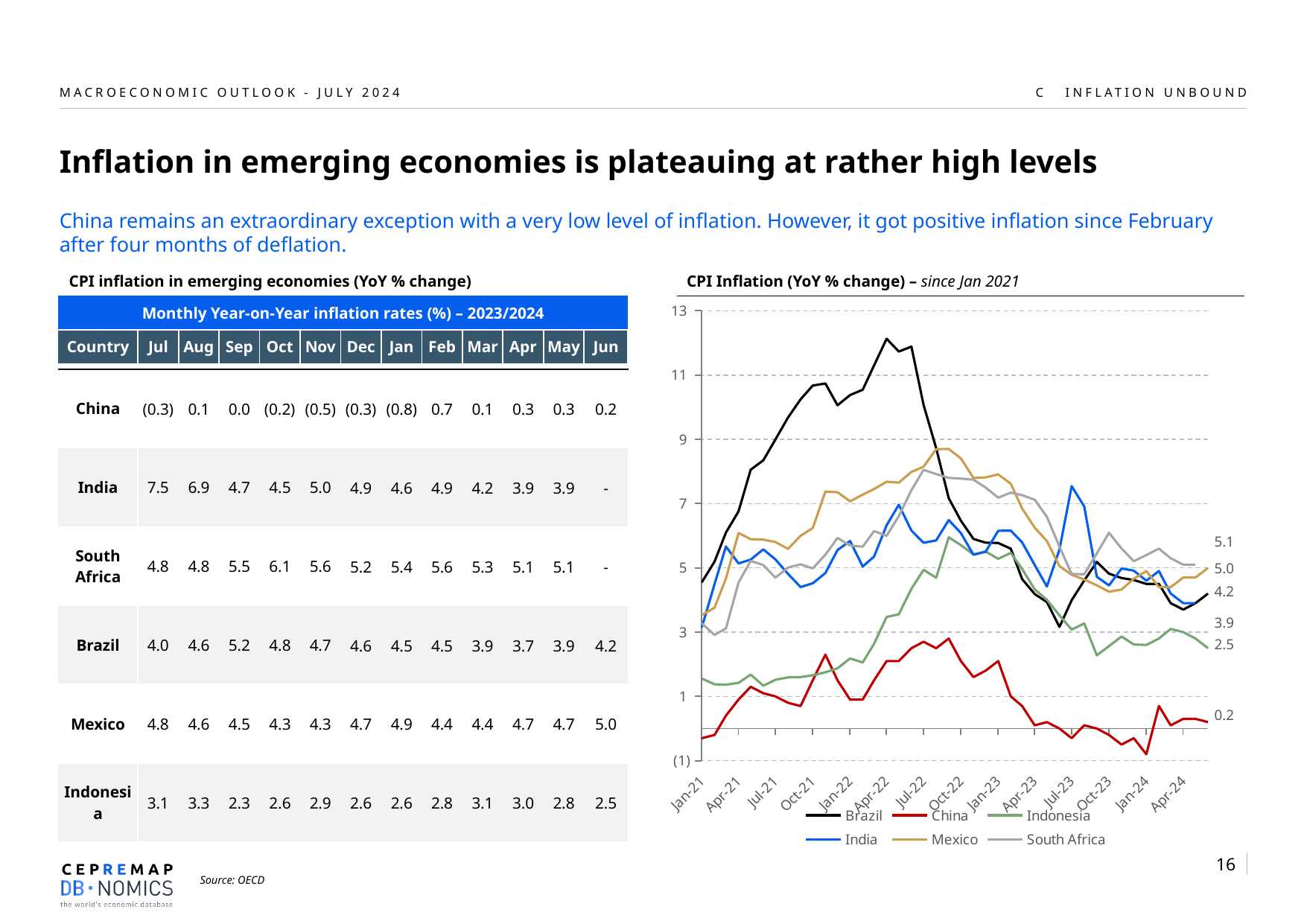
In the 'CPI Inflation (YoY % change) – since Jan 2021' chart, what is the difference between the latest labelled values for Brazil and Indonesia? 1.7 How many series does the legend of the 'CPI Inflation (YoY % change) – since Jan 2021' chart list? 6 In the 'CPI Inflation (YoY % change) – since Jan 2021' chart, does the Brazil line rise or fall between Apr-22 and Jul-23? fall In the 'CPI Inflation (YoY % change) – since Jan 2021' chart, what is the latest value labelled for China? 0.2 In the 'CPI Inflation (YoY % change) – since Jan 2021' chart, what is the latest value labelled for Mexico? 5.0 In the 'CPI Inflation (YoY % change) – since Jan 2021' chart, is the value for China in Jan-21 greater or less than 1? less In the 'CPI Inflation (YoY % change) – since Jan 2021' chart, what colour is the Brazil line? black In the 'CPI Inflation (YoY % change) – since Jan 2021' chart, which country has the highest latest labelled value? South Africa In the 'CPI Inflation (YoY % change) – since Jan 2021' chart, which country has the lowest latest labelled value? China What kind of chart is the 'CPI Inflation (YoY % change) – since Jan 2021' chart? line chart In the 'CPI Inflation (YoY % change) – since Jan 2021' chart, what is the latest value labelled for South Africa? 5.1 In the 'CPI Inflation (YoY % change) – since Jan 2021' chart, is the peak value of the Brazil line greater or less than 11? greater